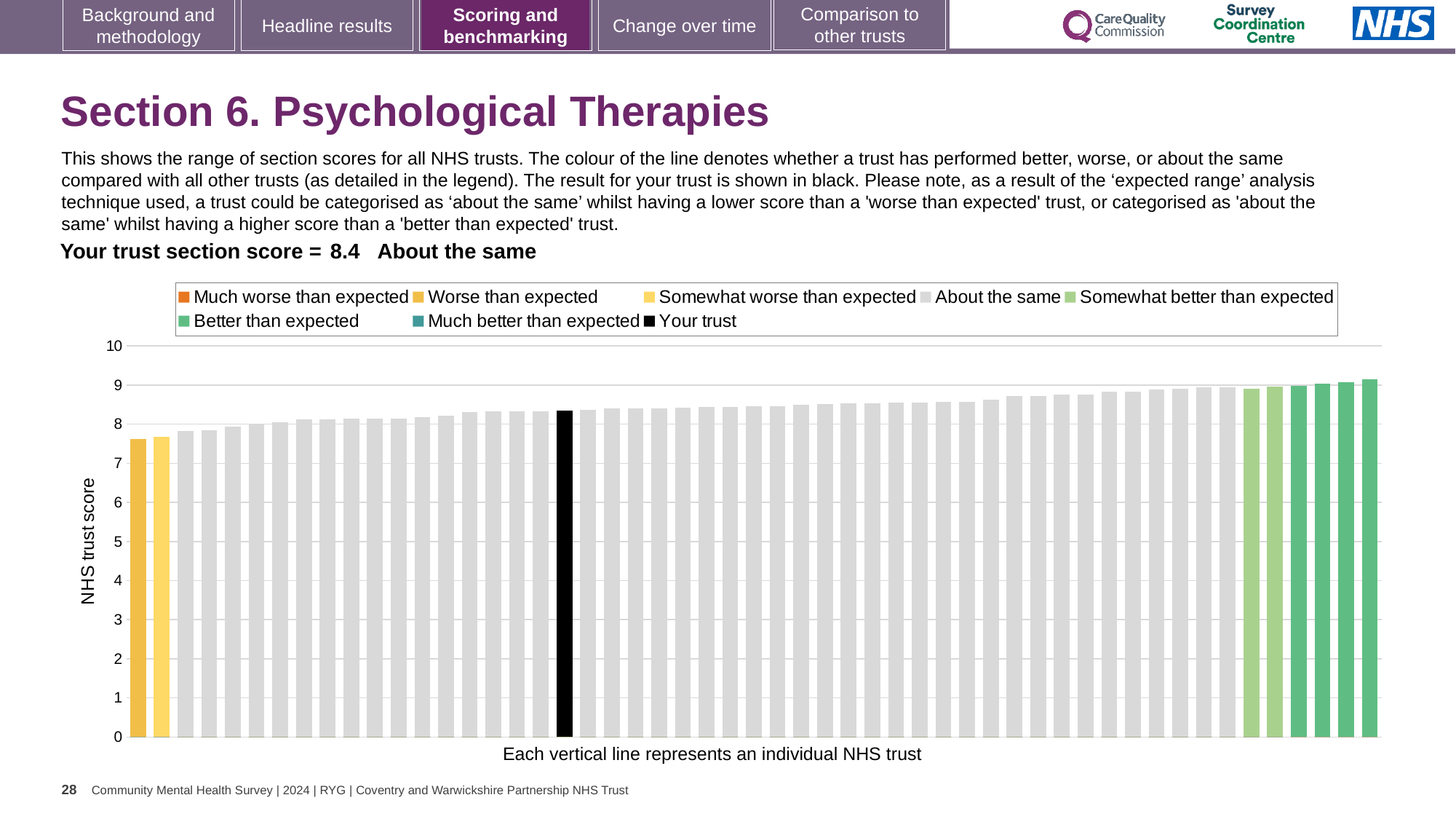
What is the label on the vertical axis of the chart? NHS trust score What colour is used for the 'Your trust' bar in the chart? black Which category is your trust placed in for this section? About the same What is the section score for your trust shown on the slide? 8.4 Is the value of the leftmost bar greater or less than 8? less Do the bar values rise or fall from left to right across the chart? rise How many entries does the chart legend list? 8 How many bars are coloured as 'Worse than expected'? 1 Is the value of the rightmost bar greater or less than 8? greater Which bar is larger, the leftmost bar or the rightmost bar? the rightmost bar What kind of chart is shown on the slide? bar chart Is the value of the black 'Your trust' bar greater or less than 8? greater